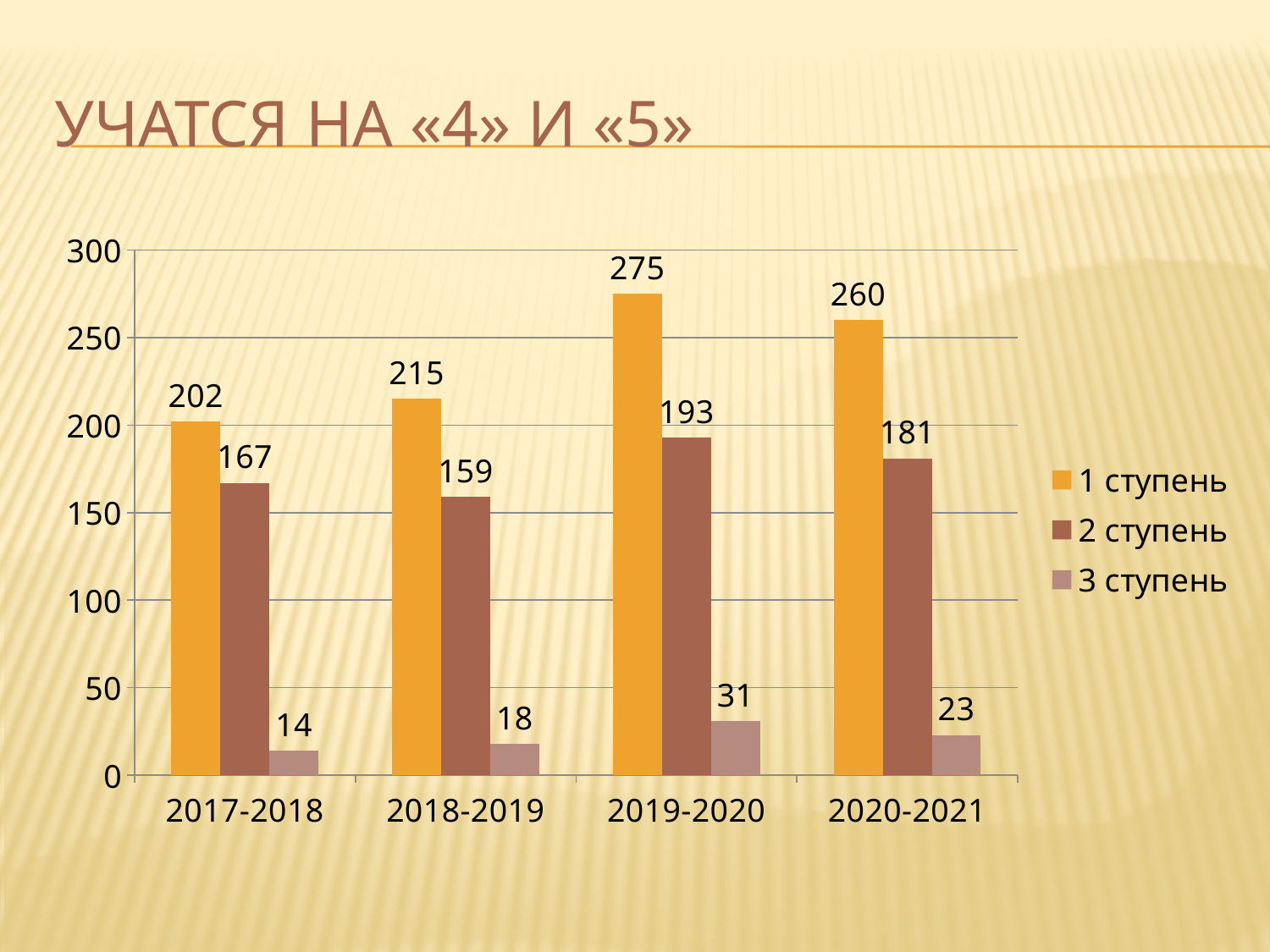
What is the title of the slide? УЧАТСЯ НА «4» И «5» In which year is the value for 1 ступень highest? 2019-2020 How many year categories are shown on the x axis? 4 What is the value for 3 ступень in 2020-2021? 23 What is the value for 1 ступень in 2019-2020? 275 Does the value for 1 ступень rise or fall from 2017-2018 to 2019-2020? rise What is the difference between 1 ступень and 2 ступень in 2020-2021? 79 In which year is the value for 3 ступень lowest? 2017-2018 How many series does the legend list? 3 Which is larger: 2 ступень in 2019-2020 or 2 ступень in 2018-2019? 2 ступень in 2019-2020 What is the value for 2 ступень in 2017-2018? 167 What kind of chart is shown on the slide? bar chart